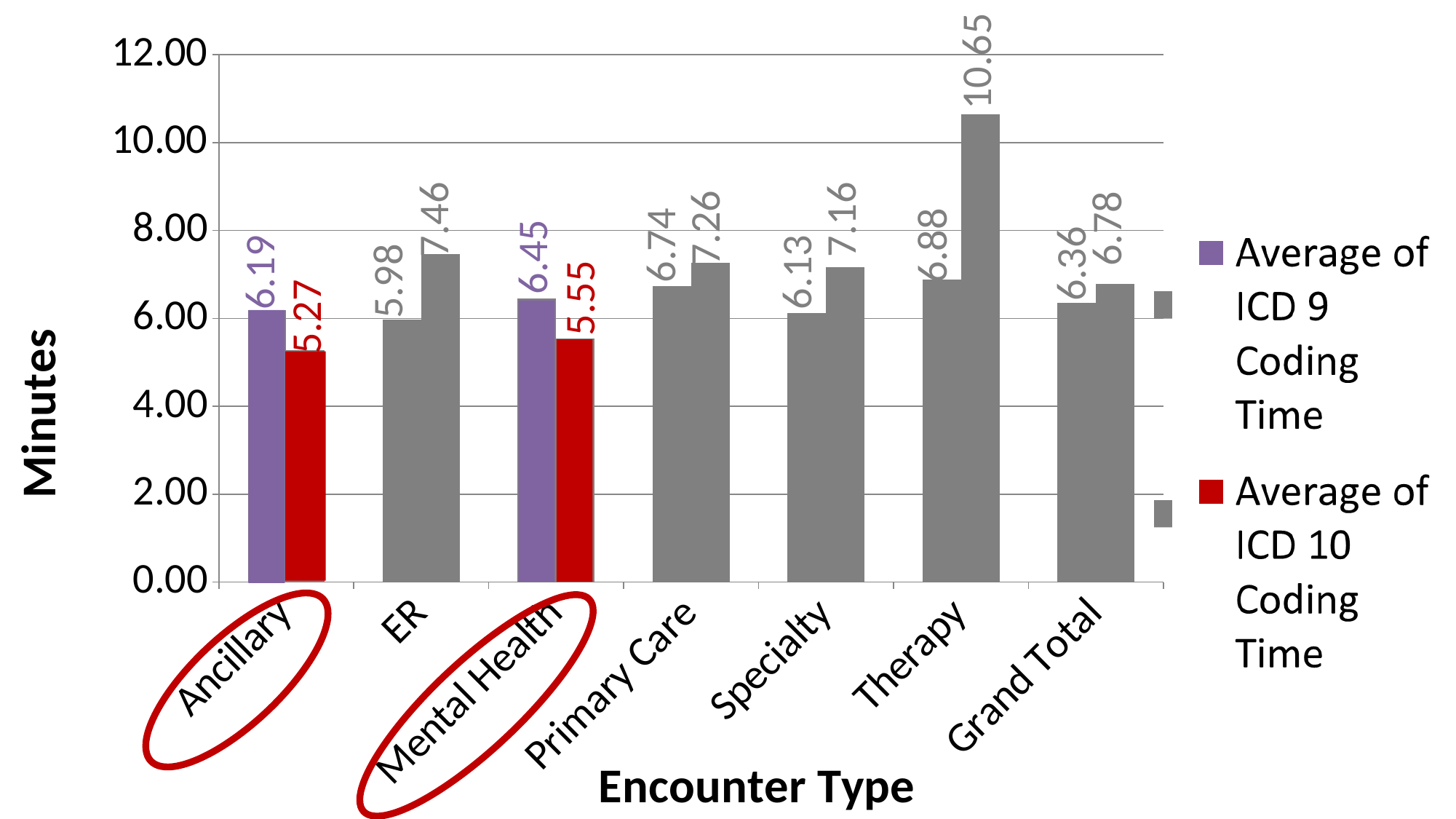
How many encounter types are shown on the x axis? 7 What is the difference between the ICD 10 and ICD 9 average coding times for Therapy? 3.77 What kind of chart is shown on the slide? bar chart What is the Average of ICD 9 Coding Time for Grand Total? 6.36 Which encounter type has the highest Average of ICD 10 Coding Time? Therapy Which encounter type has the lowest Average of ICD 9 Coding Time? ER What is the Average of ICD 10 Coding Time for Therapy? 10.65 Is the Average of ICD 10 Coding Time for Therapy greater or less than 10.00? greater What is the Average of ICD 9 Coding Time for Ancillary? 6.19 What is the Average of ICD 10 Coding Time for Mental Health? 5.55 How many series does the legend list? 2 For ER, which is larger: the Average of ICD 9 Coding Time or the Average of ICD 10 Coding Time? Average of ICD 10 Coding Time